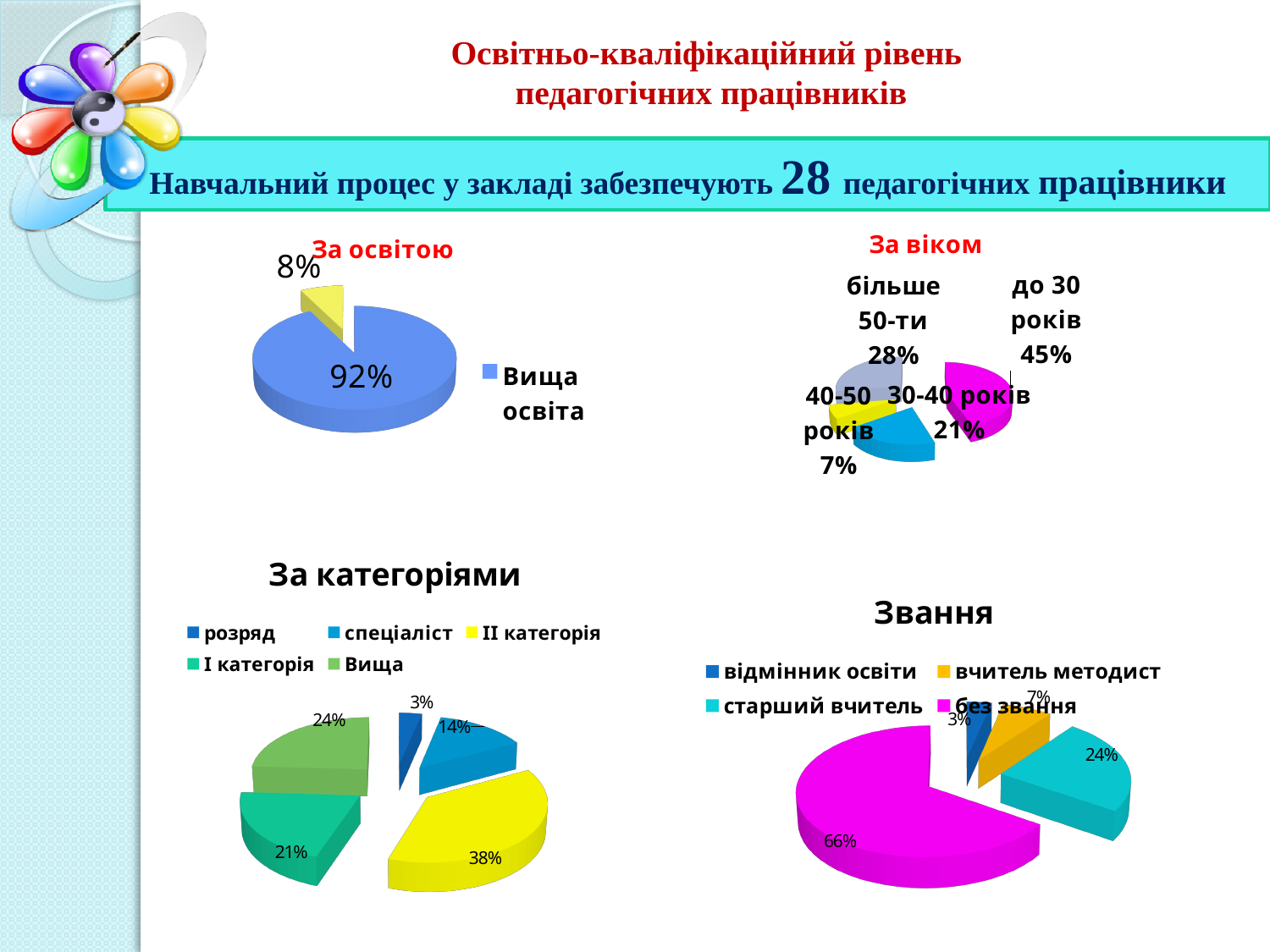
In the 'Звання' chart, what percentage is shown for 'без звання'? 66% In the 'За категоріями' chart, how many categories does the legend list? 5 How many charts are shown on the slide? 4 In the 'За віком' chart, which age group has the largest share? до 30 років In the 'За категоріями' chart, which category has the smallest share? розряд What type of chart is the 'Звання' chart? Pie chart In the 'За категоріями' chart, what percentage is shown for 'ІІ категорія'? 38% In the 'За освітою' chart, what percentage is shown for 'Вища освіта'? 92% In the 'За віком' chart, what is the difference between the shares for 'більше 50-ти' and '30-40 років'? 7% In the 'Звання' chart, which is larger: 'старший вчитель' or 'вчитель методист'? старший вчитель In the 'За віком' chart, which age group has the smallest share? 40-50 років In the 'За віком' chart, what percentage of staff are 'до 30 років'? 45%